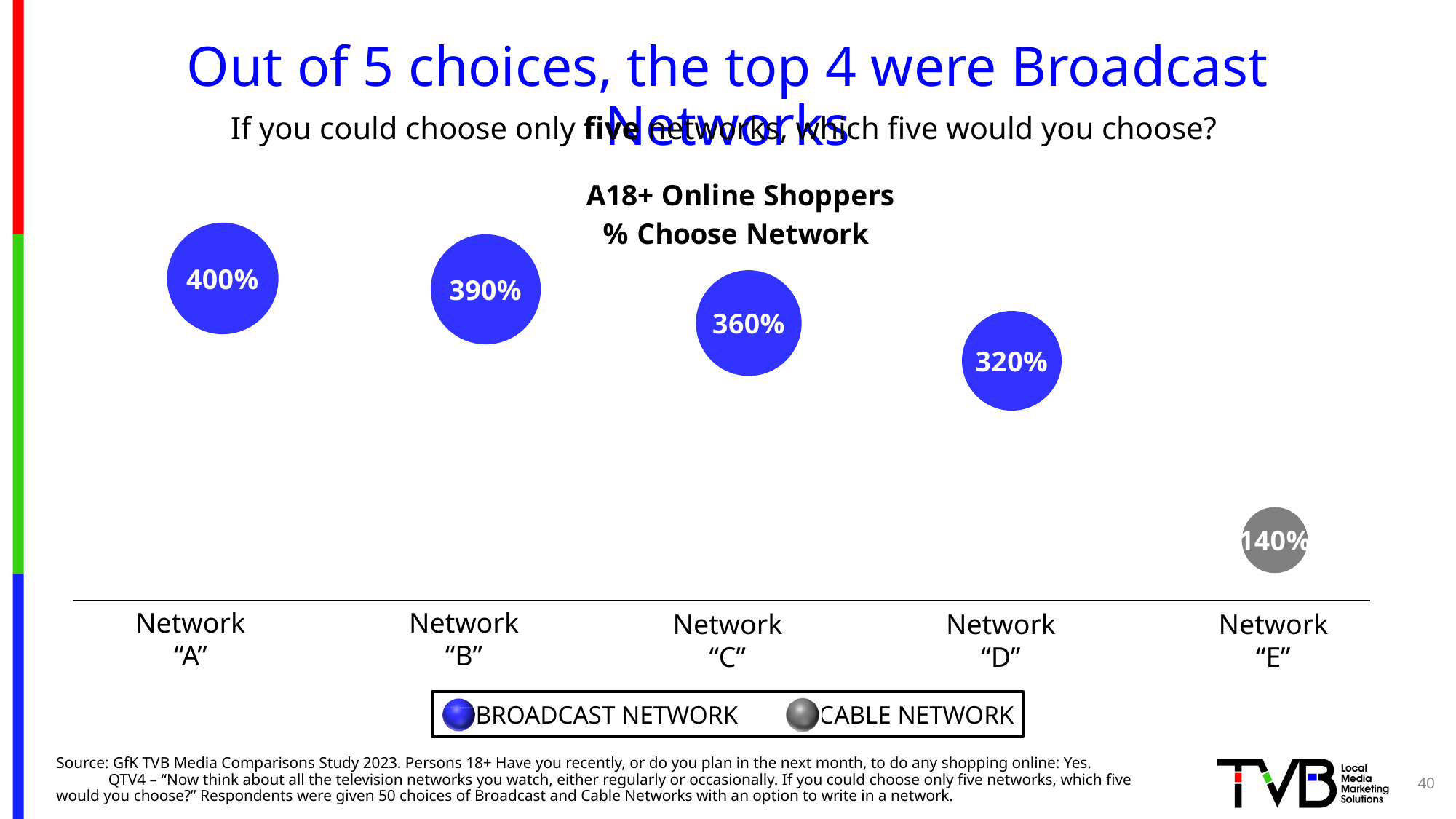
How many networks are shown in the chart? 5 What is the value for Network "E"? 140% Which network has the lowest value? Network "E" What is the difference between the values for Network "A" and Network "E"? 260% Do the values rise or fall from Network "A" to Network "E"? fall Which is larger, the value for Network "C" or Network "D"? Network "C" What is the value for Network "A"? 400% What is the value for Network "C"? 360% What is the difference between the values for Network "B" and Network "D"? 70% Which network is shown as a Cable Network in the chart? Network "E" Which network has the highest value? Network "A" How many entries does the legend list? 2